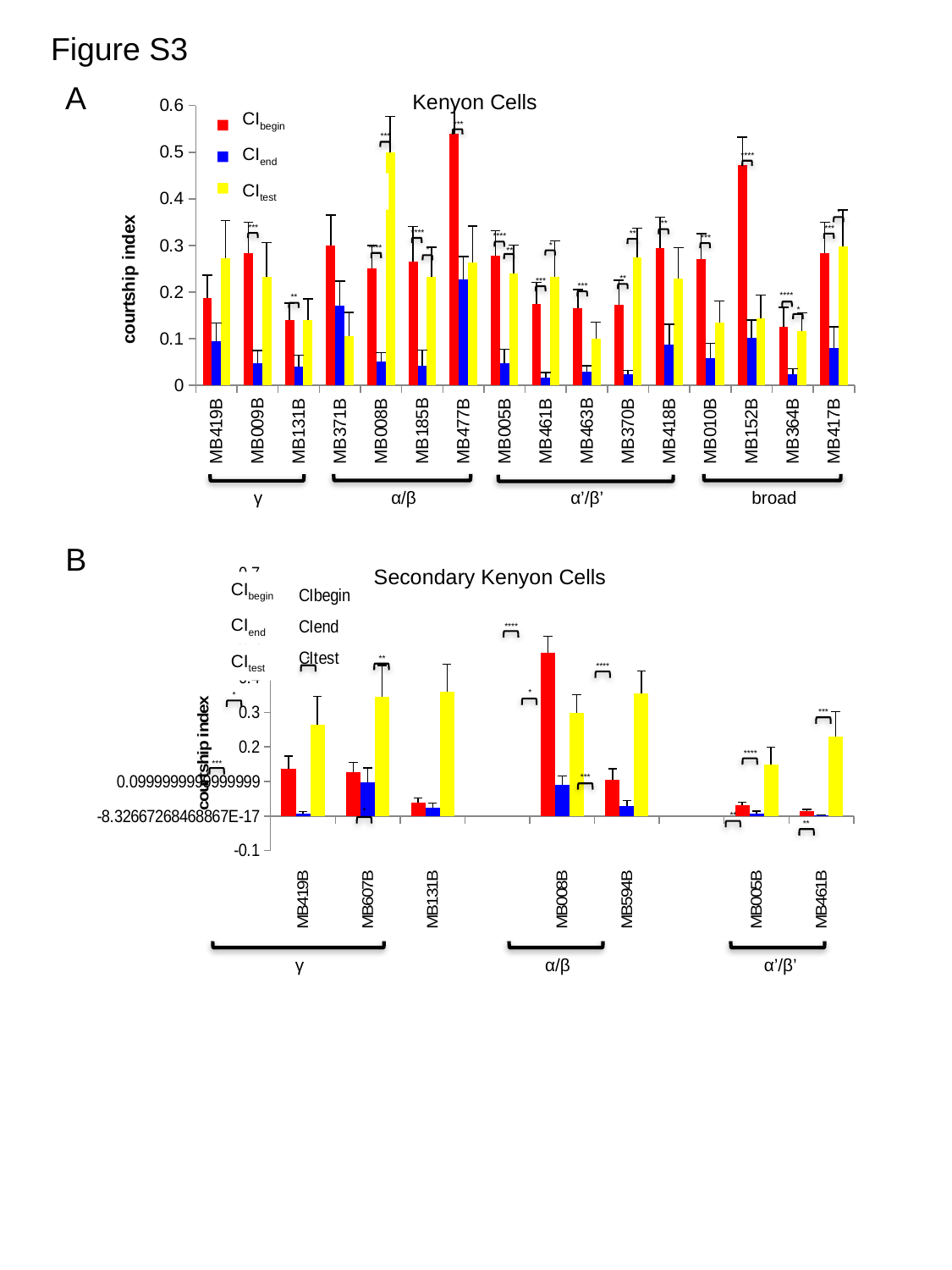
In the "Kenyon Cells" chart, which is larger for MB008B: the CI begin value or the CI test value? CI test How many series does the legend of the "Kenyon Cells" chart list? 3 How many categories are shown on the x axis of the "Kenyon Cells" chart? 16 In the "Secondary Kenyon Cells" chart, is the CI begin value for MB008B greater or less than 0.4? greater In the "Kenyon Cells" chart, is the CI begin value for MB131B greater or less than 0.2? less What kind of chart is the "Kenyon Cells" chart? bar chart In the "Kenyon Cells" chart, which category has the highest CI begin value? MB477B In the "Secondary Kenyon Cells" chart, which category has the highest CI begin value? MB008B In the "Kenyon Cells" chart, is the CI begin value for MB477B greater or less than 0.5? greater How many categories are shown on the x axis of the "Secondary Kenyon Cells" chart? 7 In the "Kenyon Cells" chart, which category has the highest CI test value? MB008B